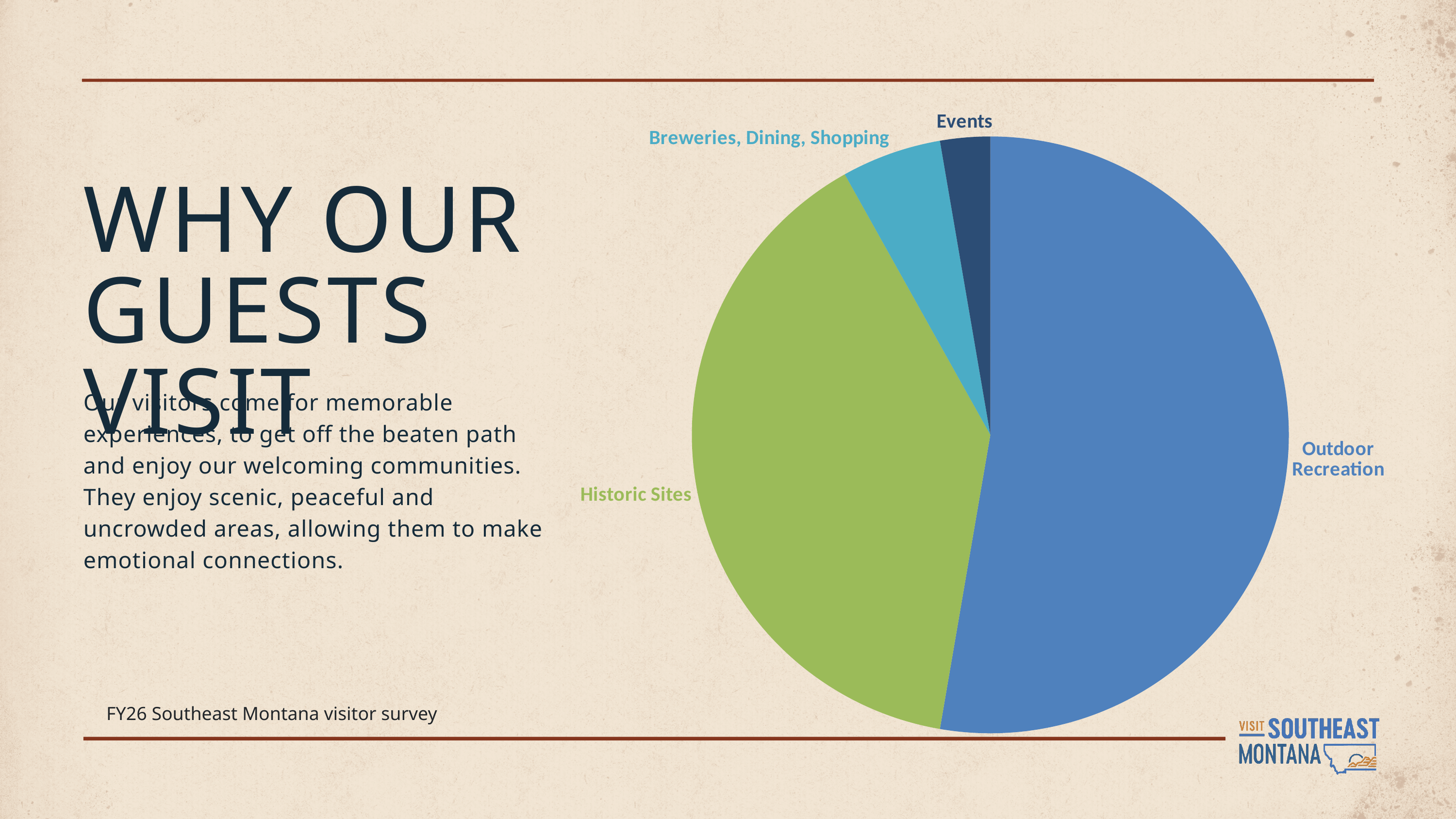
What kind of chart is shown on the slide? Pie chart What data source is cited at the bottom of the slide for the chart? FY26 Southeast Montana visitor survey Which category has the smallest slice of the pie chart? Events How many slices does the pie chart have? 4 Which slice is larger, Historic Sites or Events? Historic Sites Which category has the largest slice of the pie chart? Outdoor Recreation What colour is the Historic Sites slice of the pie chart? Green Which slice is larger, Breweries, Dining, Shopping or Events? Breweries, Dining, Shopping Which slice is larger, Outdoor Recreation or Historic Sites? Outdoor Recreation Which category has the second-largest slice of the pie chart? Historic Sites